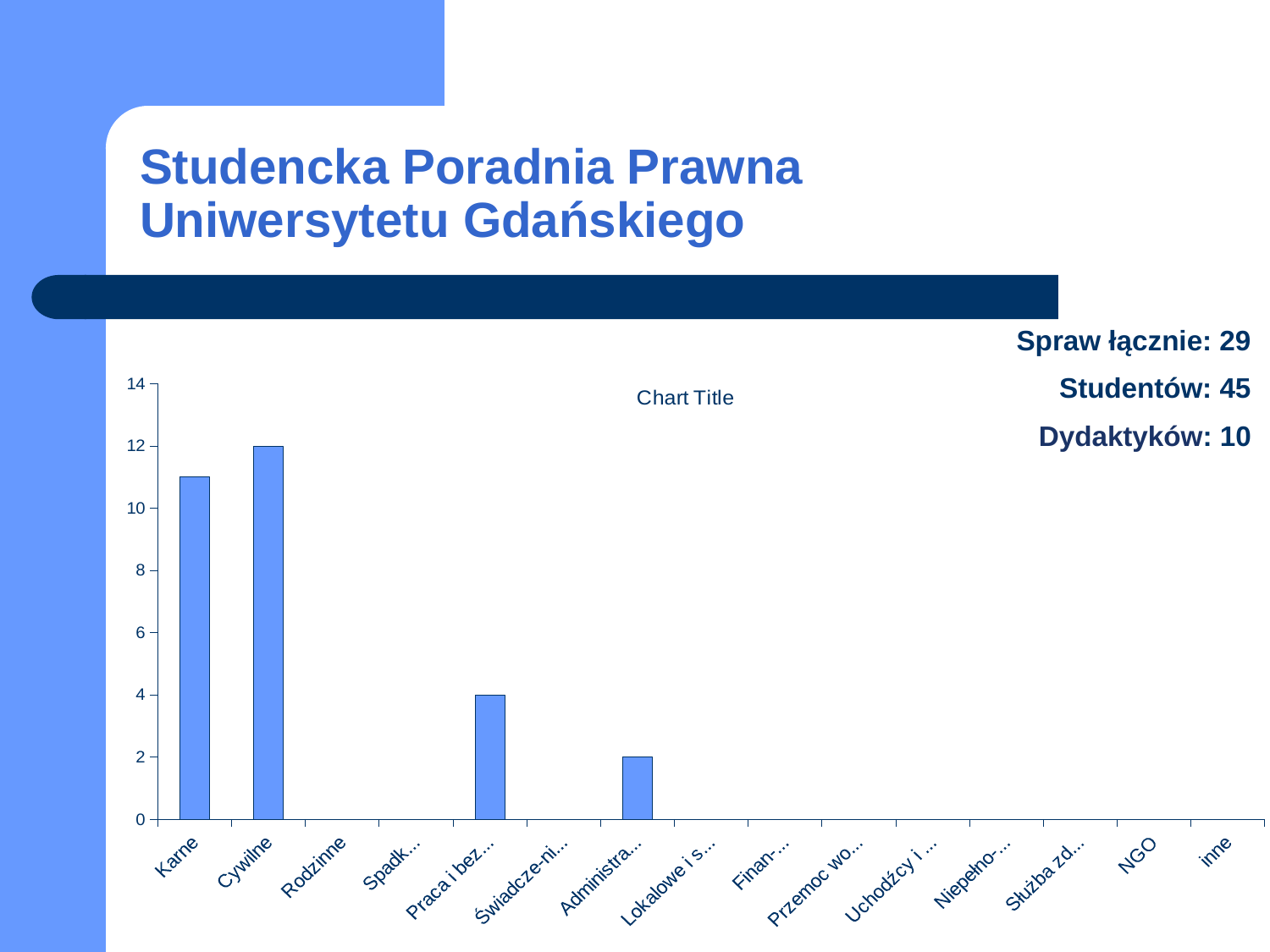
Is the value for Karne greater or less than 12? less How many categories are shown on the x axis of the chart? 15 What is the difference between the values for Cywilne and Praca i bez...? 8 What is the difference between the values for Praca i bez... and Administra...? 2 Which is larger, the value for Karne or the value for Cywilne? Cywilne Is the value for Karne greater or less than 10? greater Which category has the highest value in the chart? Cywilne What is the title shown on the chart? Chart Title What is the value for Cywilne? 12 What is the value for Praca i bez...? 4 What is the value for Administra...? 2 What kind of chart is shown on the slide? bar chart